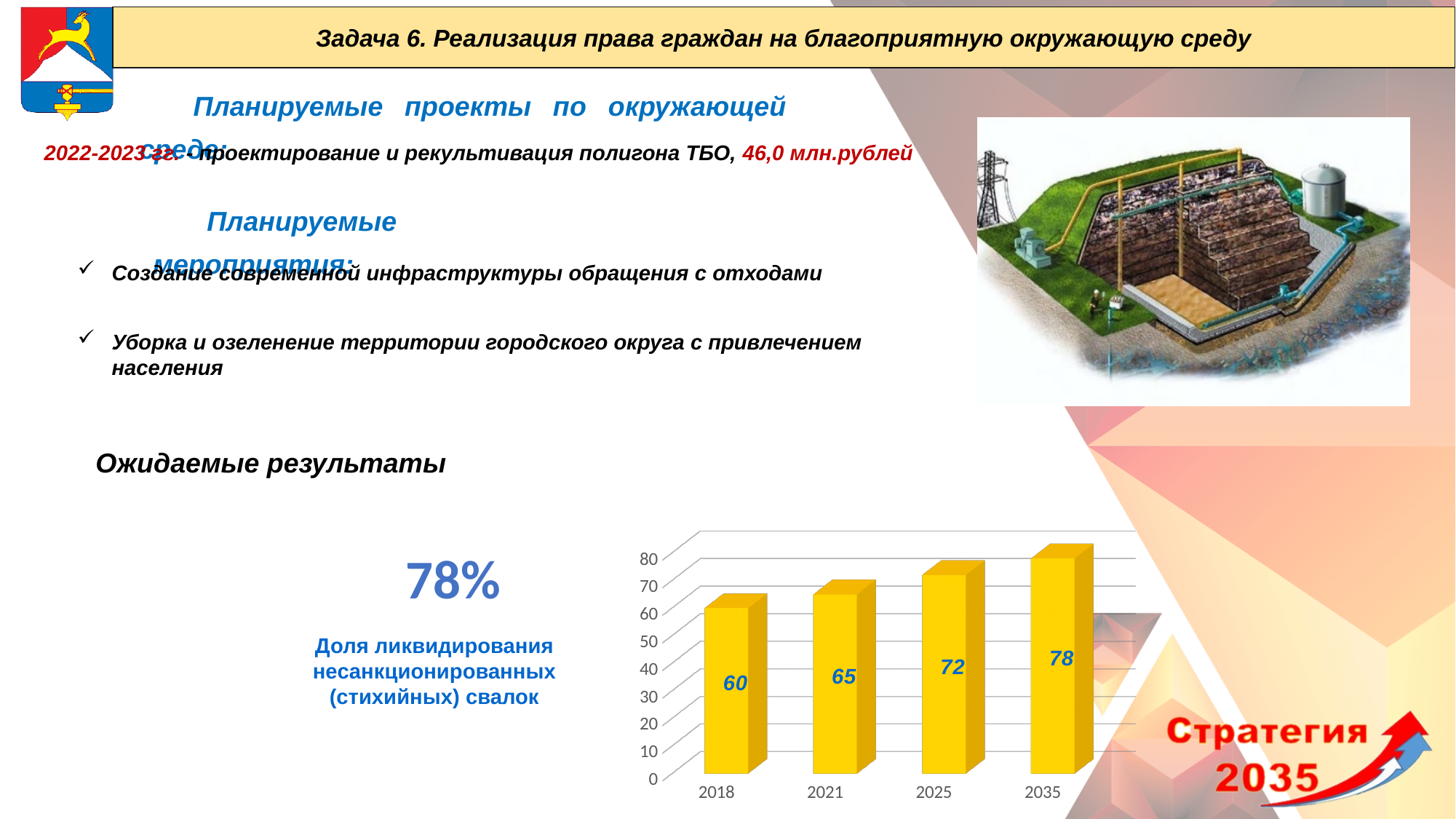
What kind of chart is shown on the slide? bar chart Which year has the highest value in the bar chart? 2035 What is the value for 2018 in the bar chart? 60 What is the difference between the values for 2035 and 2018 in the bar chart? 18 What is the value for 2035 in the bar chart? 78 What is the value for 2025 in the bar chart? 72 Do the values in the bar chart rise or fall from 2018 to 2035? rise Which is larger in the bar chart, the value for 2021 or the value for 2025? 2025 How many bars are shown in the bar chart? 4 What is the difference between the values for 2025 and 2021 in the bar chart? 7 What is the value for 2021 in the bar chart? 65 Which year has the lowest value in the bar chart? 2018